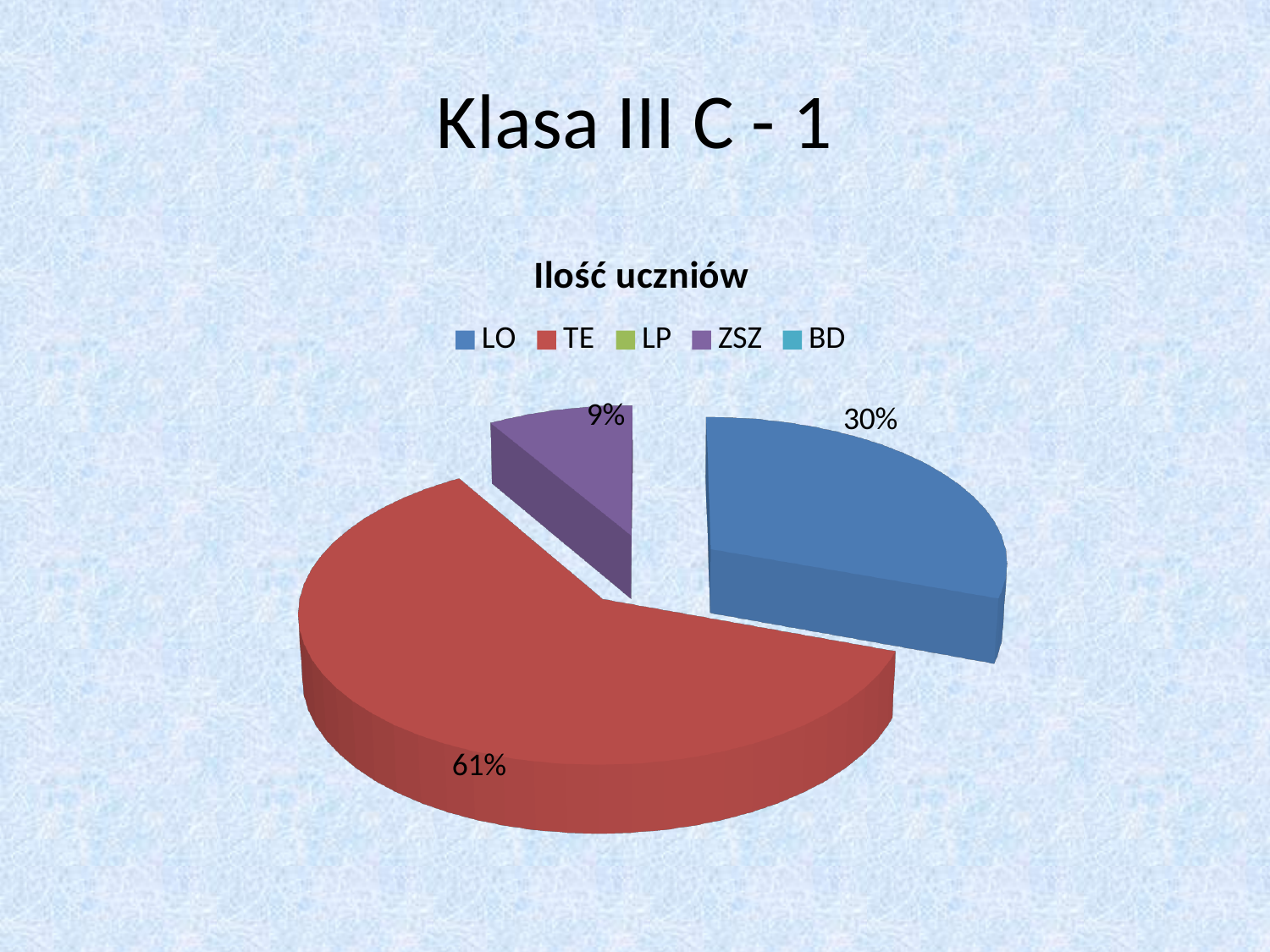
What share of the pie does ZSZ have? 9% What is the difference in percentage points between the TE and LO slices? 31 How many entries does the chart legend list? 5 What kind of chart is shown on the slide? Pie chart What share of the pie does TE have? 61% What is the difference in percentage points between the LO and ZSZ slices? 21 Which slice is larger, TE or LO? TE Which category has the largest slice of the pie? TE What is the title of the chart? Ilość uczniów What share of the pie does LO have? 30% Which slice is larger, LO or ZSZ? LO Which of the labelled slices is the smallest? ZSZ